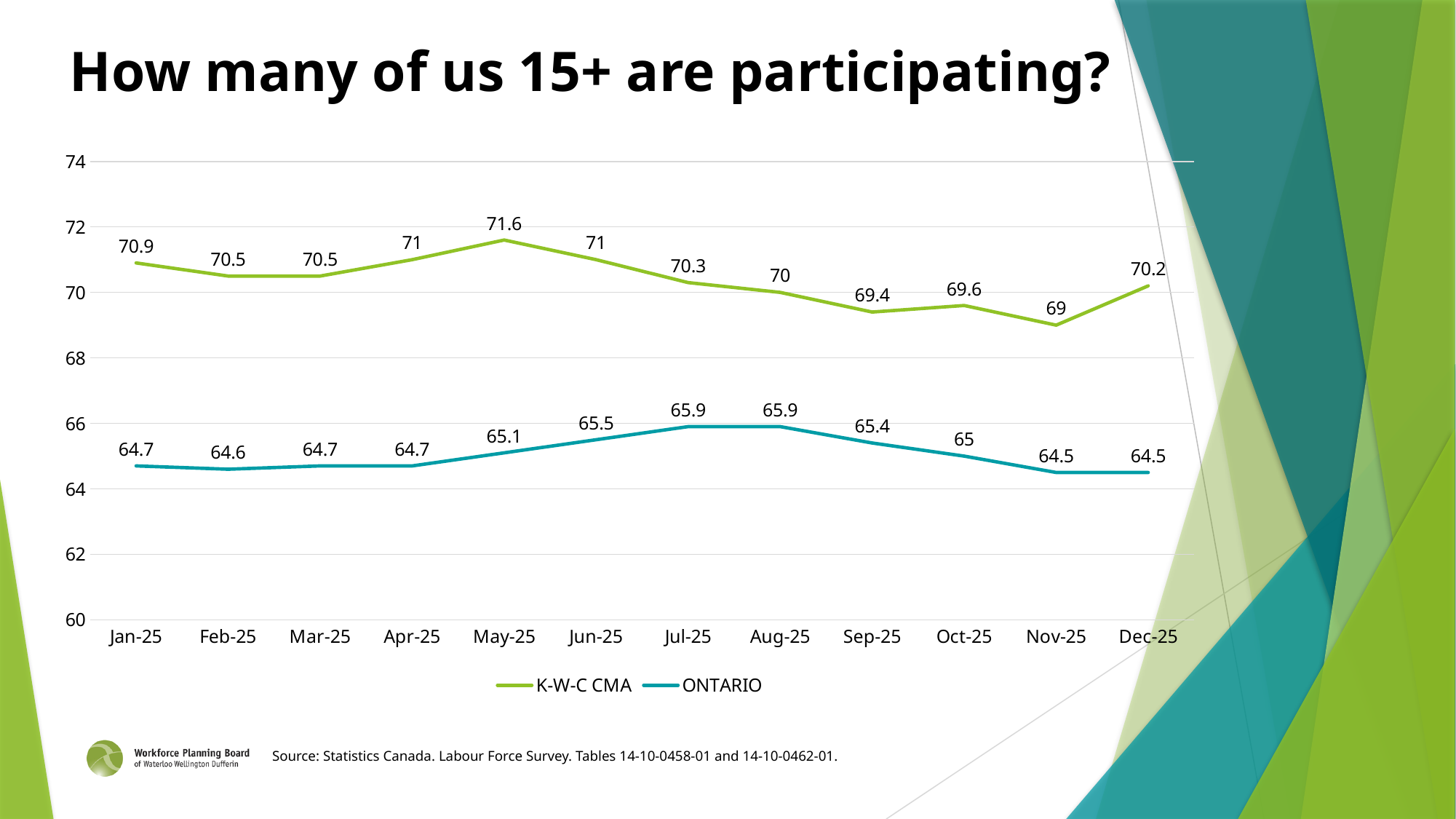
Is the ONTARIO value for Jul-25 greater or less than 66? less In which month is the K-W-C CMA series at its lowest? Nov-25 What is the title of the chart on the slide? How many of us 15+ are participating? What is the K-W-C CMA value for May-25? 71.6 What kind of chart is shown on the slide? line chart What is the difference between the K-W-C CMA and ONTARIO values in Dec-25? 5.7 How many series does the legend list? 2 What is the ONTARIO value for Feb-25? 64.6 In which month is the K-W-C CMA series at its highest? May-25 Does the ONTARIO series rise or fall from Aug-25 to Nov-25? fall How many months are shown on the x axis? 12 Which series has the higher value in Jan-25, K-W-C CMA or ONTARIO? K-W-C CMA